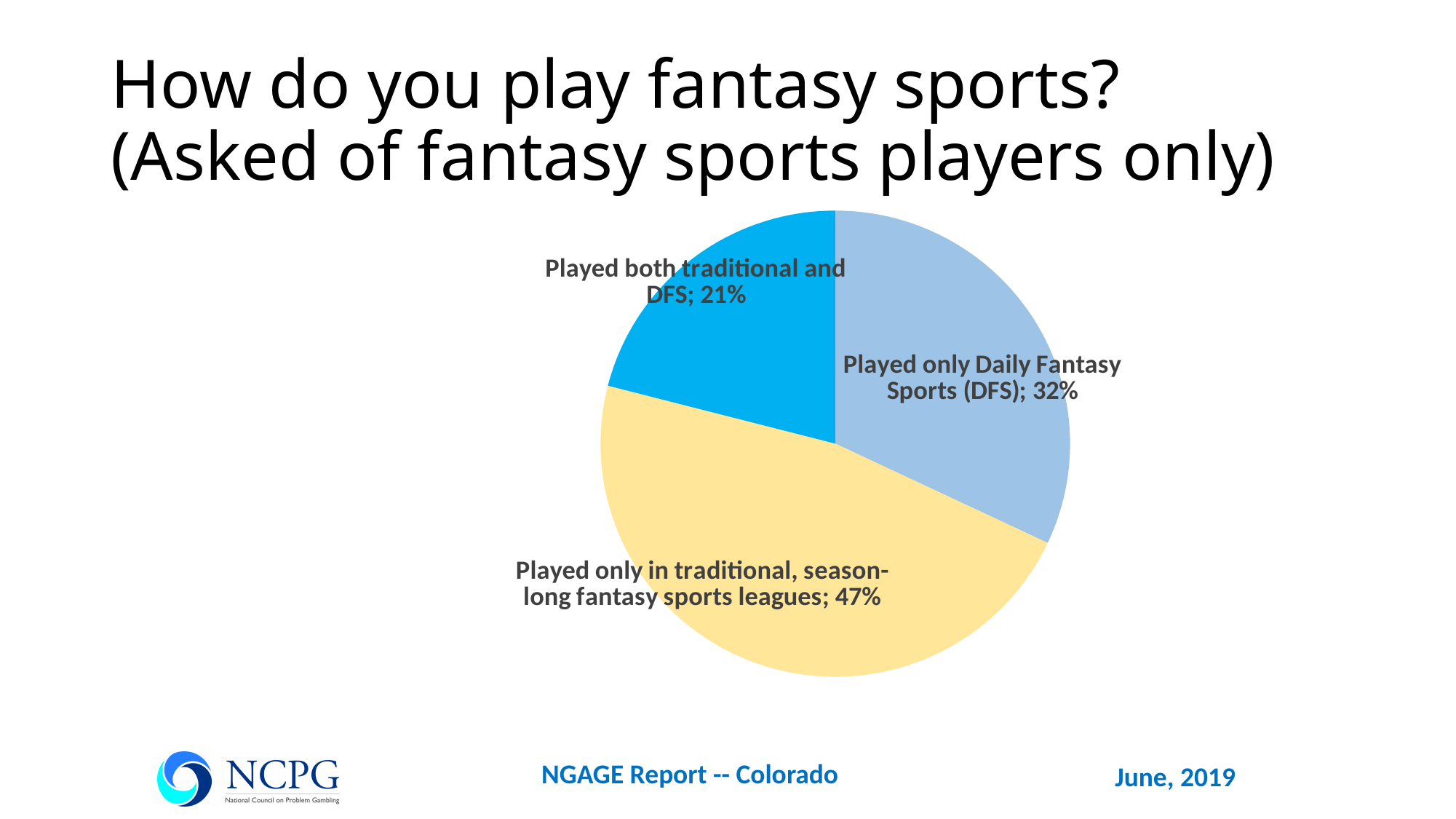
What is the difference in percentage points between the 'Played only DFS' slice and the 'Played both traditional and DFS' slice? 11 How many slices does the pie chart have? 3 What is the difference in percentage points between players who played only in traditional leagues and those who played only DFS? 15 What kind of chart is shown on the slide? pie chart Which is larger: the share that played only DFS or the share that played both traditional and DFS? Played only Daily Fantasy Sports (DFS) What percentage of fantasy sports players played both traditional and DFS? 21% What percentage of fantasy sports players played only Daily Fantasy Sports (DFS)? 32% Which category has the smallest share of the pie? Played both traditional and DFS What colour is the slice for 'Played only in traditional, season-long fantasy sports leagues'? yellow Which category has the largest share of the pie? Played only in traditional, season-long fantasy sports leagues What percentage of fantasy sports players played only in traditional, season-long fantasy sports leagues? 47% What is the title of the chart on the slide? How do you play fantasy sports? (Asked of fantasy sports players only)